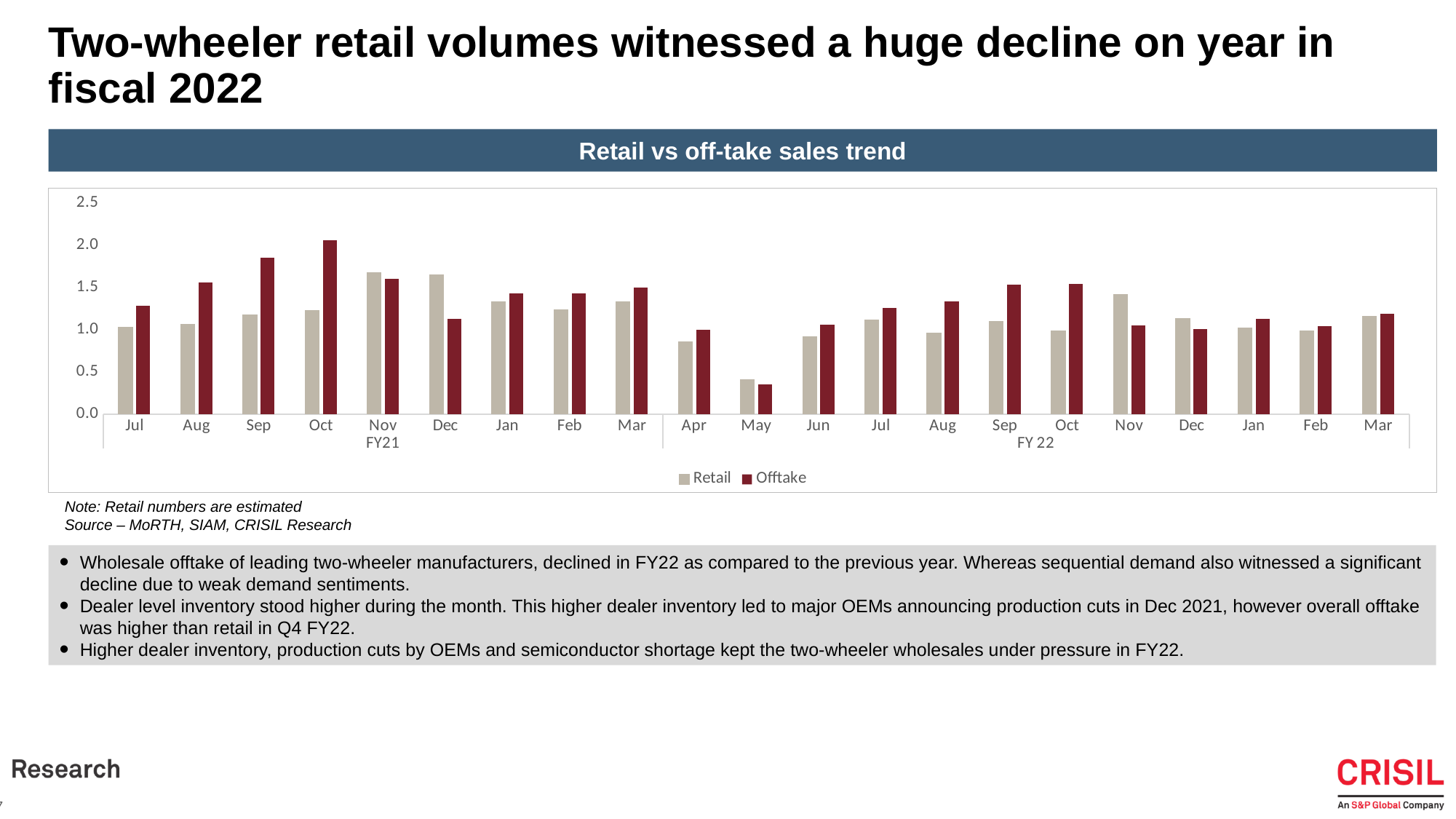
In which month is the Offtake value lowest? May FY22 In Dec FY21, which is larger, Retail or Offtake? Retail In which month is the Offtake value highest? Oct FY21 What are the two series named in the legend? Retail and Offtake Is the Offtake value for Sep FY21 greater or less than 1.5? greater How many months are plotted along the x axis? 21 Is the Retail value for May FY22 greater or less than 0.5? less Is the Retail value for Apr FY22 greater or less than 1.0? less How many series does the legend list? 2 What kind of chart is shown on the slide? bar chart In which month is the Retail value lowest? May FY22 Do the Offtake values rise or fall from Jul to Oct in FY21? rise